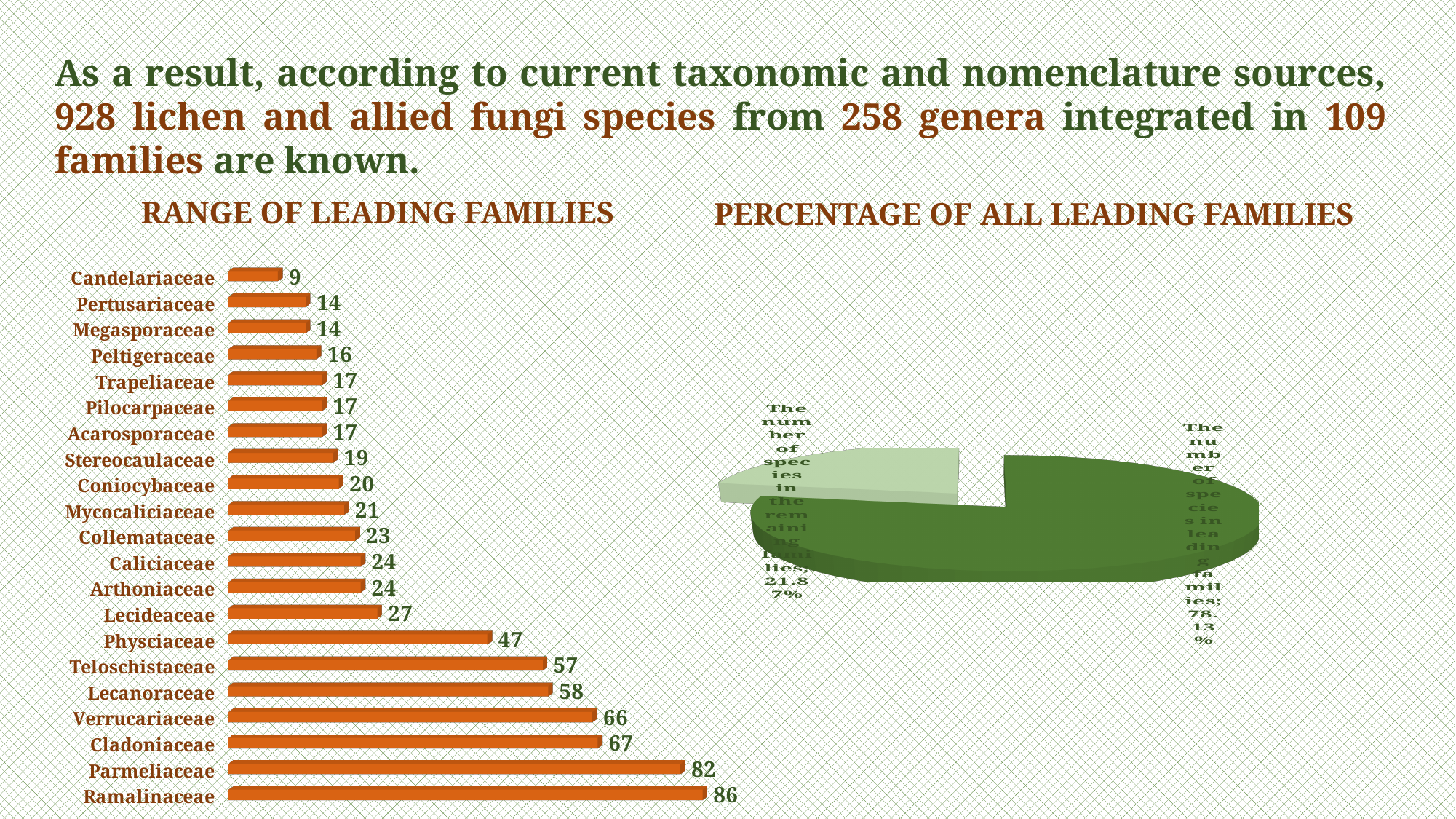
In the 'RANGE OF LEADING FAMILIES' chart, what is the value for Physciaceae? 47 How many families are shown in the 'RANGE OF LEADING FAMILIES' chart? 21 In the 'PERCENTAGE OF ALL LEADING FAMILIES' chart, what share is shown for the number of species in the remaining families? 21.87% In the 'RANGE OF LEADING FAMILIES' chart, which family has the lowest value? Candelariaceae In the 'RANGE OF LEADING FAMILIES' chart, what is the difference between the values for Parmeliaceae and Cladoniaceae? 15 In the 'RANGE OF LEADING FAMILIES' chart, what is the value for Ramalinaceae? 86 What kind of chart is the 'PERCENTAGE OF ALL LEADING FAMILIES' chart? Pie chart In the 'RANGE OF LEADING FAMILIES' chart, what is the value for Peltigeraceae? 16 In the 'PERCENTAGE OF ALL LEADING FAMILIES' chart, what share is shown for the number of species in leading families? 78.13% In the 'RANGE OF LEADING FAMILIES' chart, which has a larger value, Teloschistaceae or Lecideaceae? Teloschistaceae What kind of chart is the 'RANGE OF LEADING FAMILIES' chart? Bar chart In the 'RANGE OF LEADING FAMILIES' chart, which family has the highest value? Ramalinaceae